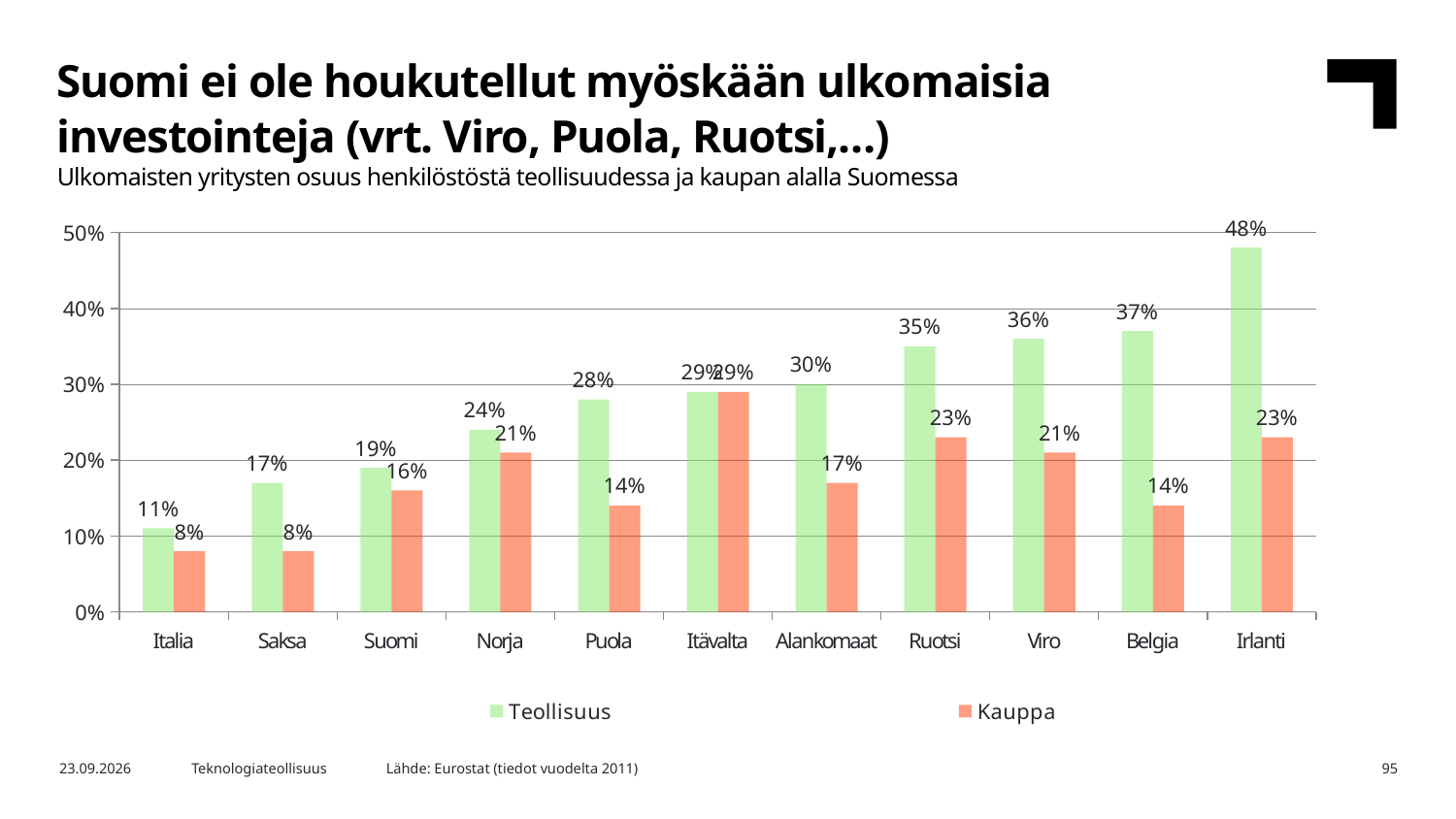
Which country has the lowest Teollisuus value? Italia Which country has the highest Teollisuus value? Irlanti How many countries are shown on the x axis? 11 Which is larger, the Kauppa value for Norja or the Kauppa value for Puola? Norja What is the Kauppa value for Itävalta? 29% What kind of chart is shown on the slide? Bar chart Do the Teollisuus values rise or fall from Italia to Irlanti along the x axis? Rise What is the difference between the Teollisuus values for Irlanti and Suomi? 29 percentage points What is the Teollisuus value for Suomi? 19% How many series does the legend list? 2 What is the Kauppa value for Ruotsi? 23% Is the Teollisuus value for Viro greater or less than 30%? greater